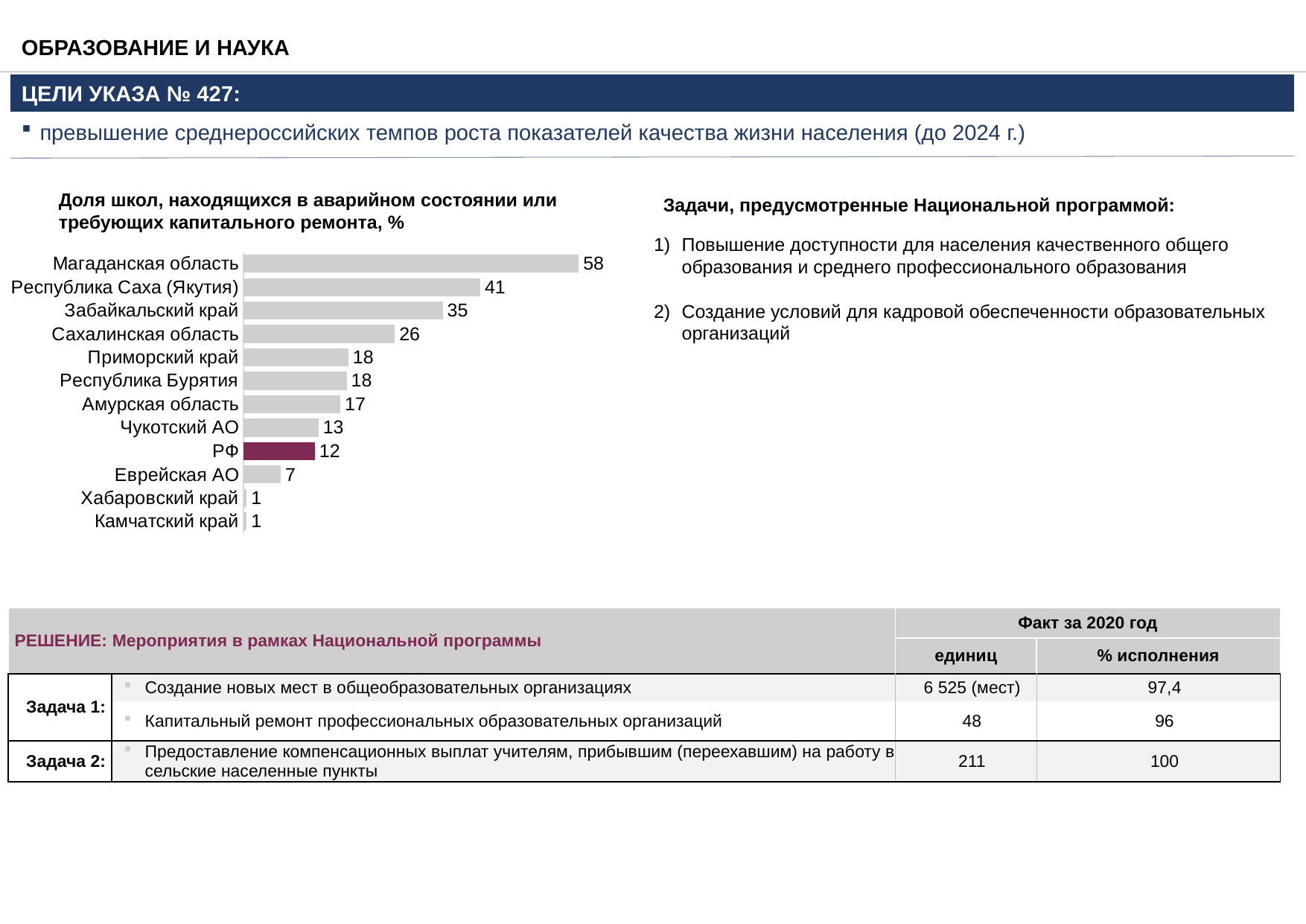
Which bar in the chart is highlighted in a different (dark magenta) colour from the others? РФ What is the value for РФ in the chart of the share of schools in emergency condition or requiring major repairs? 12 What is the value for Магаданская область in the chart 'Доля школ, находящихся в аварийном состоянии или требующих капитального ремонта, %'? 58 What is the difference between the values for Магаданская область and Республика Саха (Якутия) in the chart? 17 What is the difference between the values for Сахалинская область and РФ in the chart? 14 What type of chart is used to show the share of schools in emergency condition or requiring major repairs? Bar chart What is the value for Сахалинская область in the chart? 26 How many categories (regions, including РФ) are shown in the chart? 12 Which has a larger value in the chart: Забайкальский край or Сахалинская область? Забайкальский край Which has a larger value in the chart: Чукотский АО or Амурская область? Амурская область What is the value for Еврейская АО in the chart? 7 Which region has the highest share of schools in emergency condition or requiring major repairs in the chart? Магаданская область